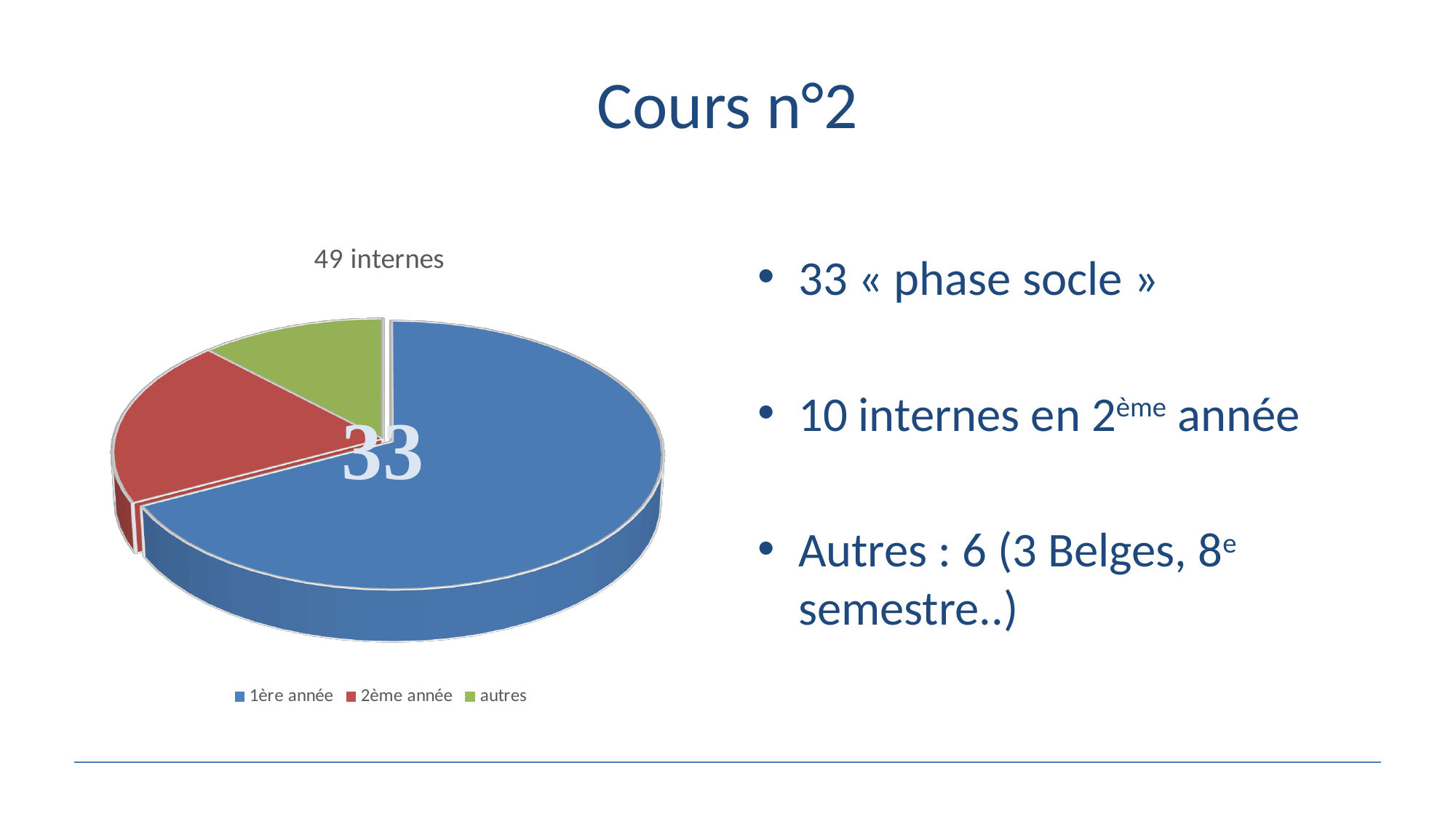
What kind of chart is shown on the slide? pie chart Which slice is larger, 1ère année or 2ème année? 1ère année Which colour represents 2ème année in the pie chart? red Which category has the smallest slice in the pie chart? autres What is the title of the pie chart? 49 internes How many entries does the chart legend list? 3 Which category has the largest slice in the pie chart? 1ère année What value is printed on the 1ère année slice of the pie chart? 33 How many slices does the pie chart have? 3 Which slice is larger, 2ème année or autres? 2ème année